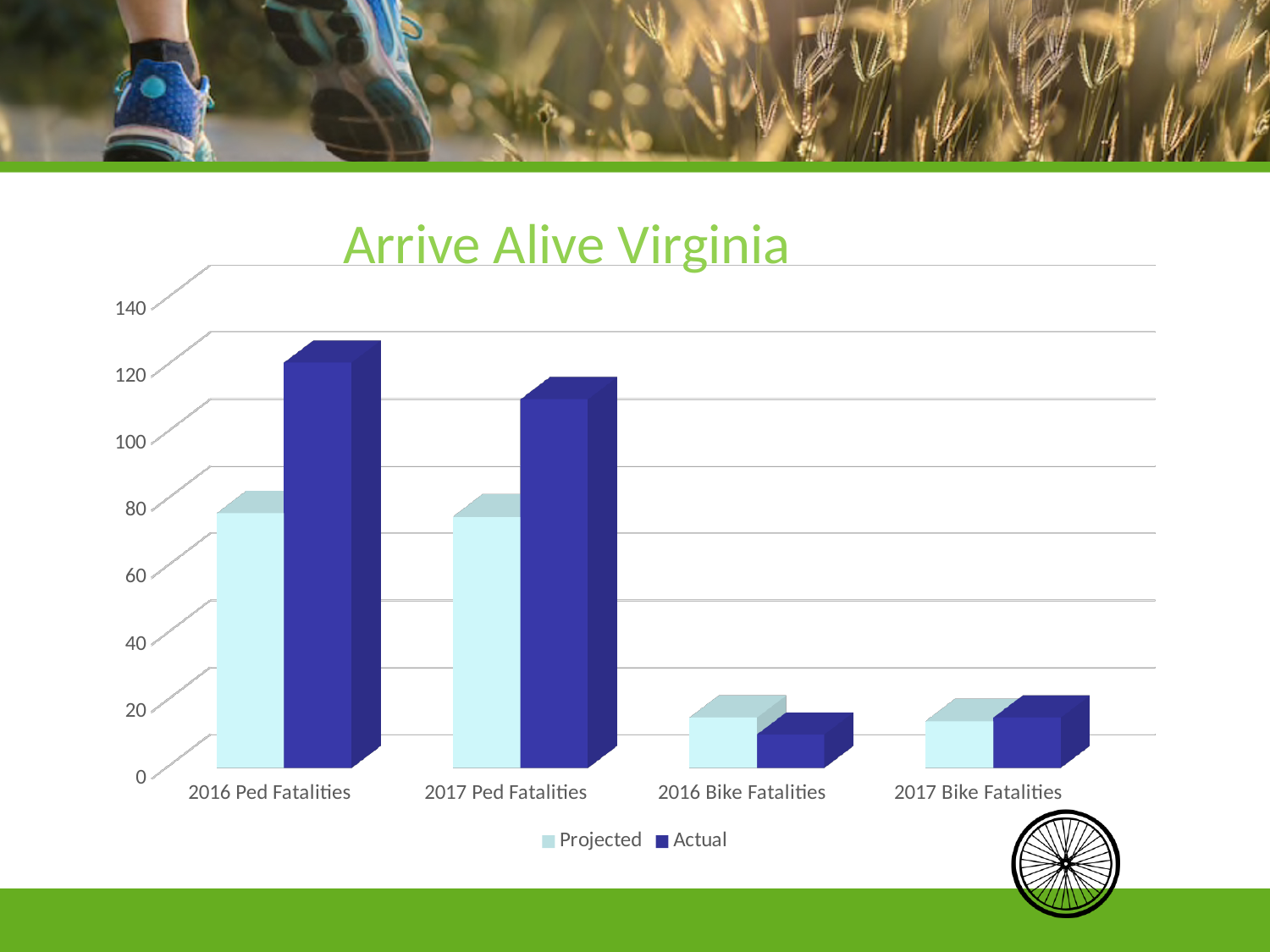
For 2016 Ped Fatalities, which is larger, the Projected or the Actual value? Actual Is the Actual value for 2016 Bike Fatalities greater or less than 20? less How many series does the legend list? 2 Is the Actual value for 2016 Ped Fatalities greater or less than 100? greater Which series is shown in dark blue in the legend? Actual For 2016 Bike Fatalities, which is larger, the Projected or the Actual value? Projected Is the Projected value for 2016 Ped Fatalities greater or less than 100? less What kind of chart is shown on the slide? bar chart Which category has the highest Actual value? 2016 Ped Fatalities Which category has the lowest Actual value? 2016 Bike Fatalities How many categories are shown on the x axis? 4 What is the title of the chart? Arrive Alive Virginia